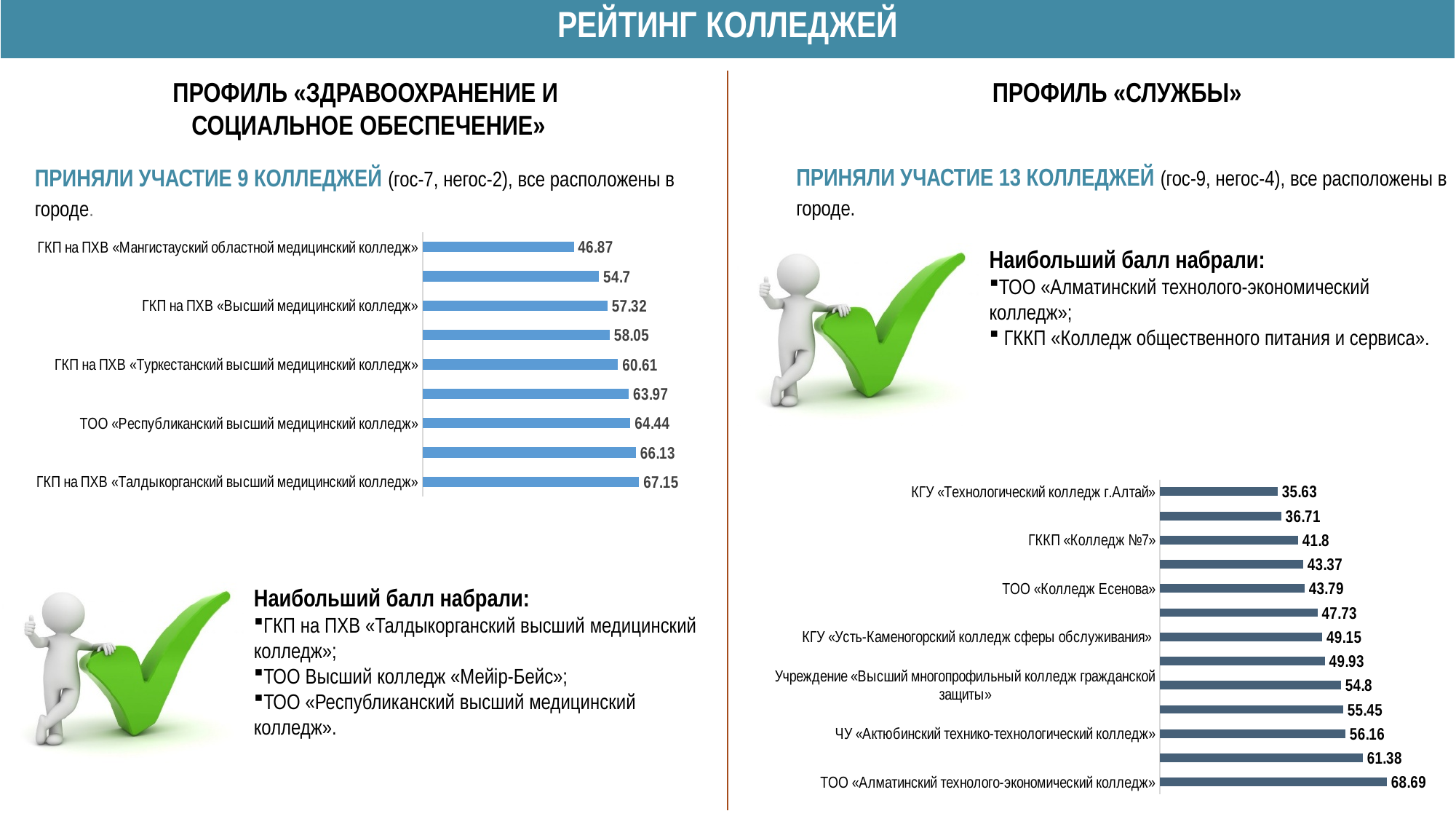
What type of chart is used on the right side of the slide? Bar chart On the left chart, which is larger: the value for ТОО «Республиканский высший медицинский колледж» or for ГКП на ПХВ «Высший медицинский колледж»? ТОО «Республиканский высший медицинский колледж» On the left chart, what is the value for ГКП на ПХВ «Мангистауский областной медицинский колледж»? 46.87 On the right chart (profile «Службы»), what is the value for ТОО «Алматинский технолого-экономический колледж»? 68.69 On the left chart (profile «Здравоохранение и социальное обеспечение»), what is the value for ГКП на ПХВ «Талдыкорганский высший медицинский колледж»? 67.15 On the left chart, what is the difference between the values for ГКП на ПХВ «Талдыкорганский высший медицинский колледж» and ГКП на ПХВ «Туркестанский высший медицинский колледж»? 6.54 On the right chart, which college has the highest value? ТОО «Алматинский технолого-экономический колледж» On the right chart, what is the value for ГККП «Колледж №7»? 41.8 On the left chart, which college has the lowest value? ГКП на ПХВ «Мангистауский областной медицинский колледж» On the right chart, how many bars are plotted? 13 On the left chart, how many bars are plotted? 9 On the right chart, what is the difference between the values for ЧУ «Актюбинский технико-технологический колледж» and КГУ «Технологический колледж г.Алтай»? 20.53